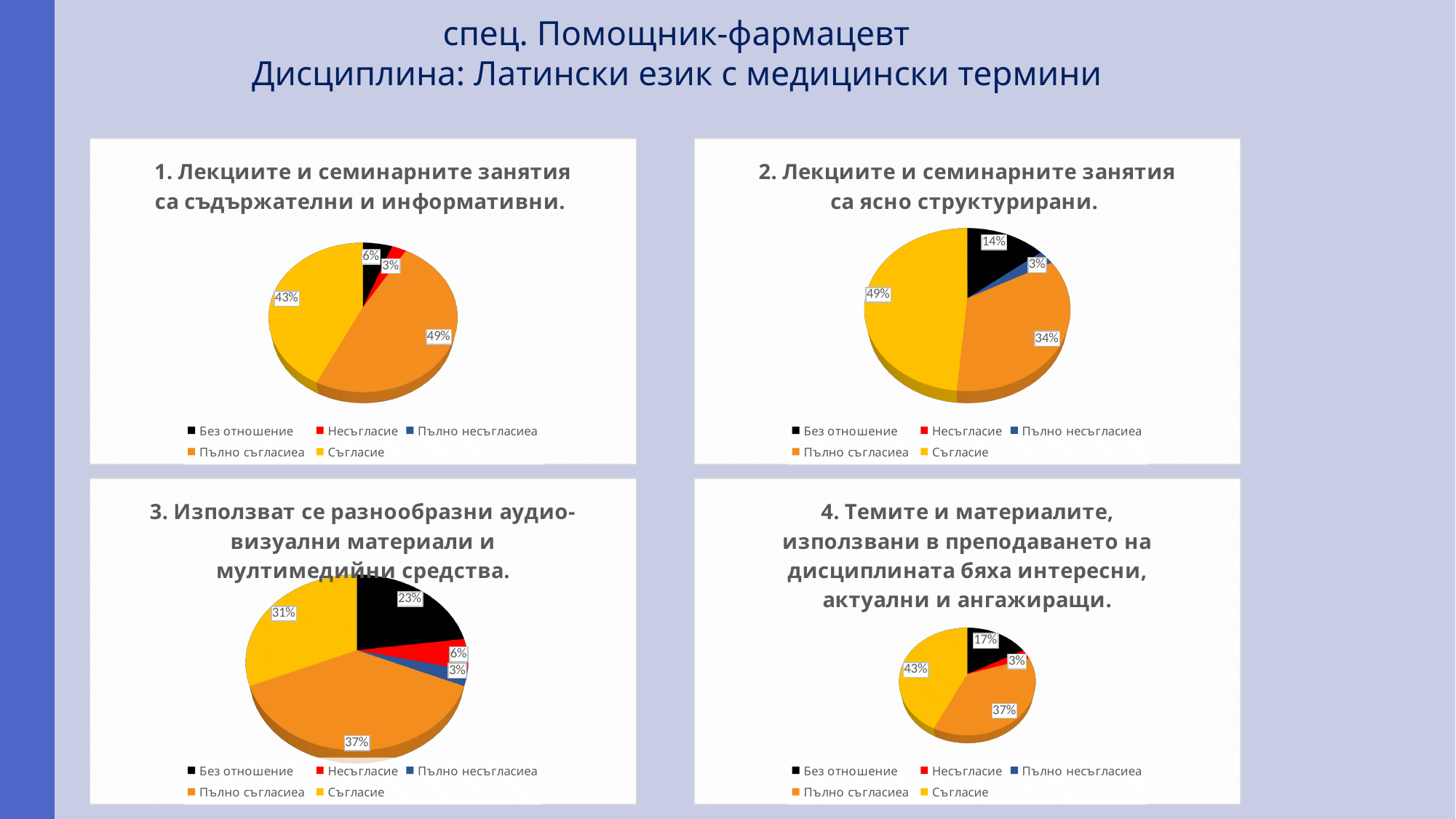
In chart 2 ("Лекциите и семинарните занятия са ясно структурирани"), which category has the largest slice? Съгласие In chart 3 ("Използват се разнообразни аудио-визуални материали и мултимедийни средства"), what share is labelled for Без отношение? 23% In chart 4 ("Темите и материалите, използвани в преподаването..."), what is the difference between the Съгласие and Без отношение shares? 26% How many entries does the legend of chart 1 list? 5 What type of chart is used for each of the four charts on the slide? Pie chart In chart 3 ("Използват се разнообразни аудио-визуални материали и мултимедийни средства"), which is larger: Несъгласие or Пълно несъгласиеа? Несъгласие In chart 4 ("Темите и материалите, използвани в преподаването..."), what share is labelled for Пълно съгласиеа? 37% In chart 1 ("Лекциите и семинарните занятия са съдържателни и информативни"), what share is labelled for Съгласие? 43% In chart 2 ("Лекциите и семинарните занятия са ясно структурирани"), what is the difference between the Съгласие and Пълно съгласиеа shares? 15% In chart 1 ("Лекциите и семинарните занятия са съдържателни и информативни"), what share is labelled for Пълно съгласиеа? 49% In chart 3 ("Използват се разнообразни аудио-визуални материали и мултимедийни средства"), which category has the largest slice? Пълно съгласиеа In chart 2 ("Лекциите и семинарните занятия са ясно структурирани"), what share is labelled for Без отношение? 14%